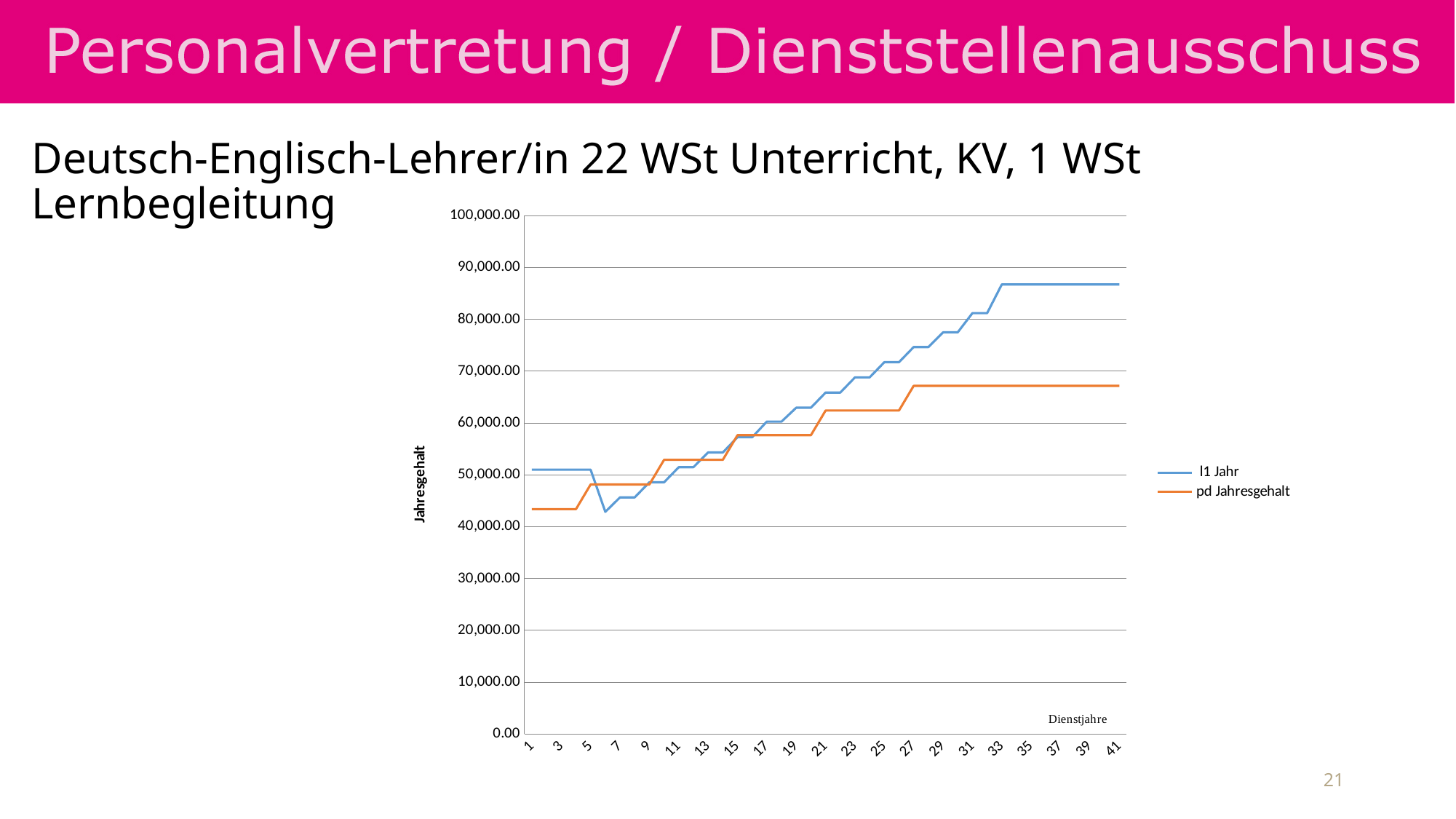
Is the value of the pd Jahresgehalt series at Dienstjahr 41 greater or less than 70,000.00? less Is the value of the l1 Jahr series at Dienstjahr 1 greater or less than 60,000.00? less At Dienstjahr 41, which series has the higher value, l1 Jahr or pd Jahresgehalt? l1 Jahr At Dienstjahr 11, which series has the higher value, l1 Jahr or pd Jahresgehalt? pd Jahresgehalt At Dienstjahr 25, which series has the higher value, l1 Jahr or pd Jahresgehalt? l1 Jahr Is the value of the l1 Jahr series at Dienstjahr 41 greater or less than 80,000.00? greater What are the two series named in the legend? l1 Jahr and pd Jahresgehalt How many series does the chart's legend list? 2 Overall, do the values of the l1 Jahr series rise or fall as the Dienstjahre increase? rise What is the title of the vertical axis of the chart? Jahresgehalt What kind of chart is shown on the slide? line chart